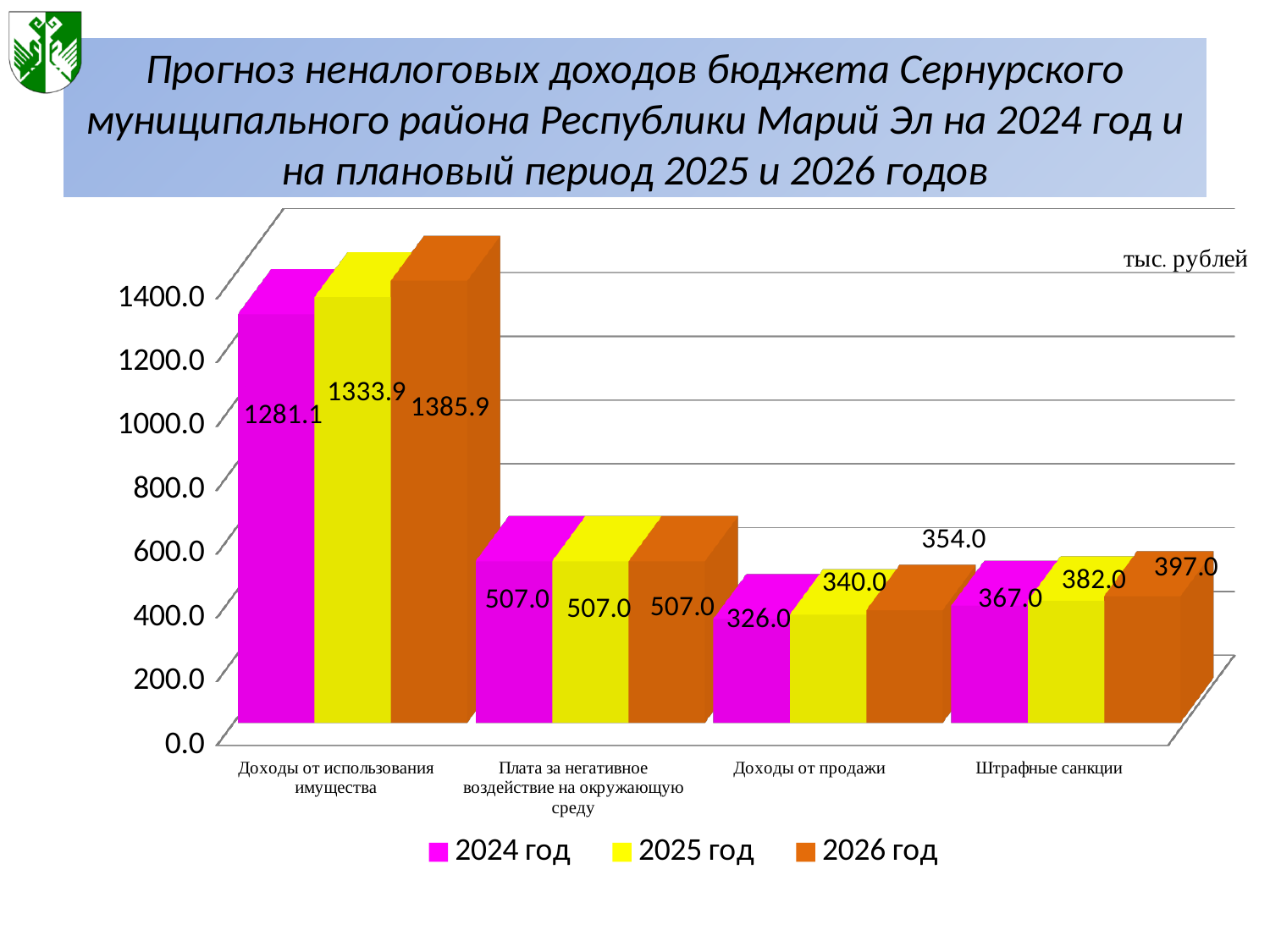
What is the value for 2024 год in the category Доходы от использования имущества? 1281.1 What is the difference between the 2026 год and 2024 год values for Доходы от использования имущества? 104.8 What is the value for 2026 год in the category Штрафные санкции? 397.0 Which is larger: the 2025 год value for Штрафные санкции or the 2025 год value for Доходы от продажи? Штрафные санкции How many series does the legend list? 3 Do the values for Штрафные санкции rise or fall from 2024 год to 2026 год? rise Which category has the highest value for 2026 год? Доходы от использования имущества How many categories are shown on the x axis? 4 Which category has the lowest value for 2024 год? Доходы от продажи What kind of chart is shown on the slide? bar chart What unit is indicated in the top right corner of the chart? тыс. рублей What is the value for 2025 год in the category Доходы от продажи? 340.0